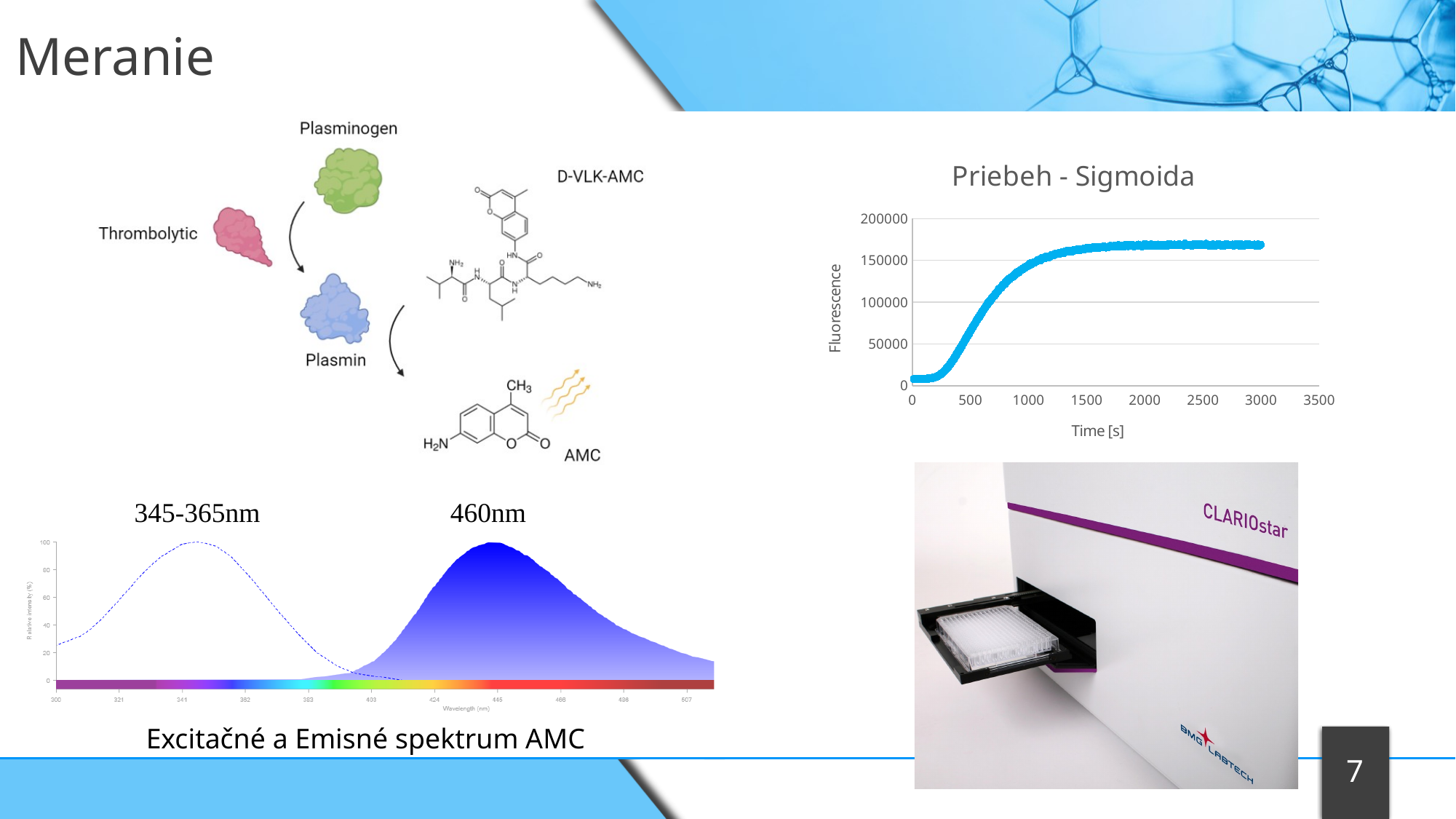
What is the title of the scatter chart on the right side of the slide? Priebeh - Sigmoida What kind of chart is the 'Priebeh - Sigmoida' chart? scatter chart In the 'Priebeh - Sigmoida' chart, is the fluorescence at 3000 s greater or less than 100000? greater In the 'Excitačné a Emisné spektrum AMC' chart, what wavelength range is labelled above the excitation peak (the dashed curve)? 345-365nm In the 'Priebeh - Sigmoida' chart, what is the label of the x axis? Time [s] In the 'Priebeh - Sigmoida' chart, is the fluorescence at 200 s greater or less than 50000? less In the 'Priebeh - Sigmoida' chart, is the fluorescence at 2000 s greater or less than 150000? greater In the 'Excitačné a Emisné spektrum AMC' chart, what wavelength is labelled above the emission peak (the filled blue curve)? 460nm In the 'Priebeh - Sigmoida' chart, does the fluorescence rise or fall as time increases from 0 to 1000 s? rise In the 'Priebeh - Sigmoida' chart, what is the highest value shown on the y axis? 200000 In the 'Priebeh - Sigmoida' chart, is the fluorescence larger at 500 s or at 1500 s? 1500 s